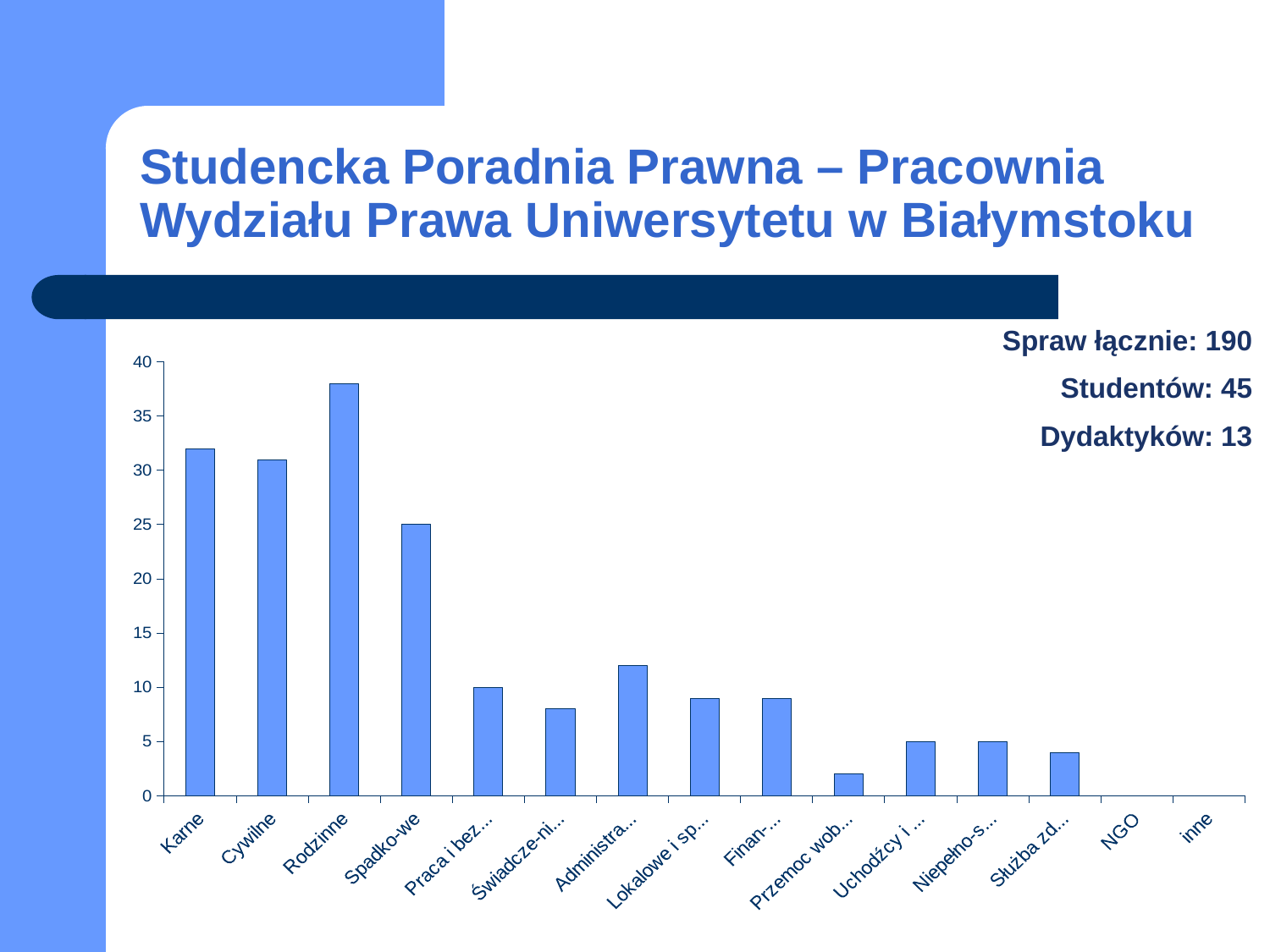
What is the value for NGO? 0 Which is larger, the value for Spadko-we or the value for Administra...? Spadko-we Is the value for Rodzinne greater or less than 35? greater How many categories are shown on the x axis of the chart? 15 Is the value for Karne greater or less than 30? greater What kind of chart is shown on the slide? bar chart What is the value for Praca i bez...? 10 What is the value for Spadko-we? 25 Which category has the highest bar in the chart? Rodzinne What is the value for Uchodźcy i ...? 5 Is the value for Przemoc wob... greater or less than 5? less Which is larger, the value for Rodzinne or the value for Karne? Rodzinne